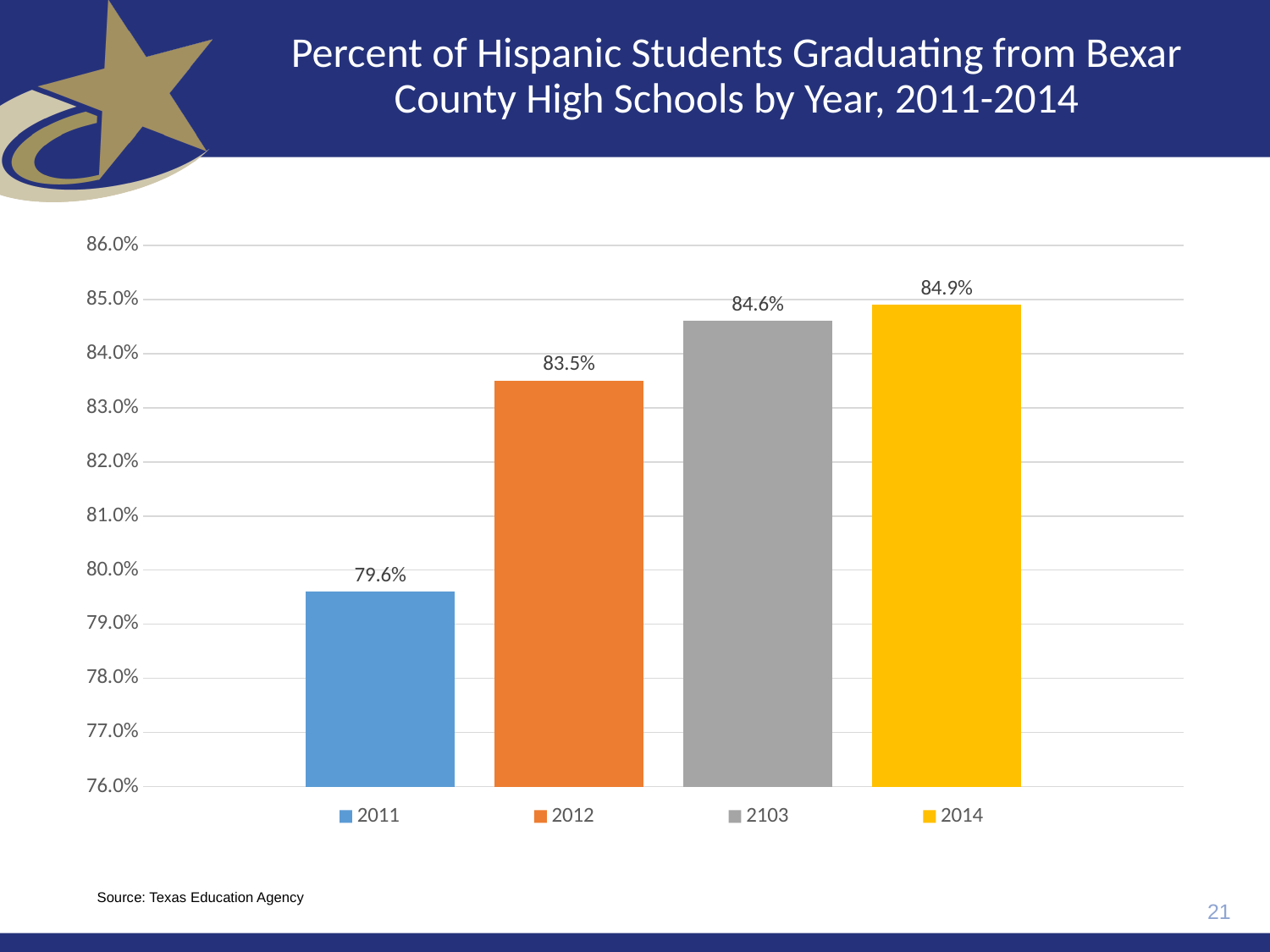
What is the difference between the values for 2012 and 2011? 3.9% Which year has the lowest graduation percentage? 2011 Which year has the highest graduation percentage? 2014 What is the difference between the values for 2014 and 2011? 5.3% What is the value for the grey bar labelled 2103 in the legend? 84.6% How many bars are shown in the chart? 4 Is the value for 2011 greater or less than 80.0%? less Which is larger, the value for 2012 or the value for 2014? 2014 What kind of chart is shown on the slide? bar chart What is the value for 2014? 84.9% What is the value for 2011? 79.6% What is the value for 2012? 83.5%